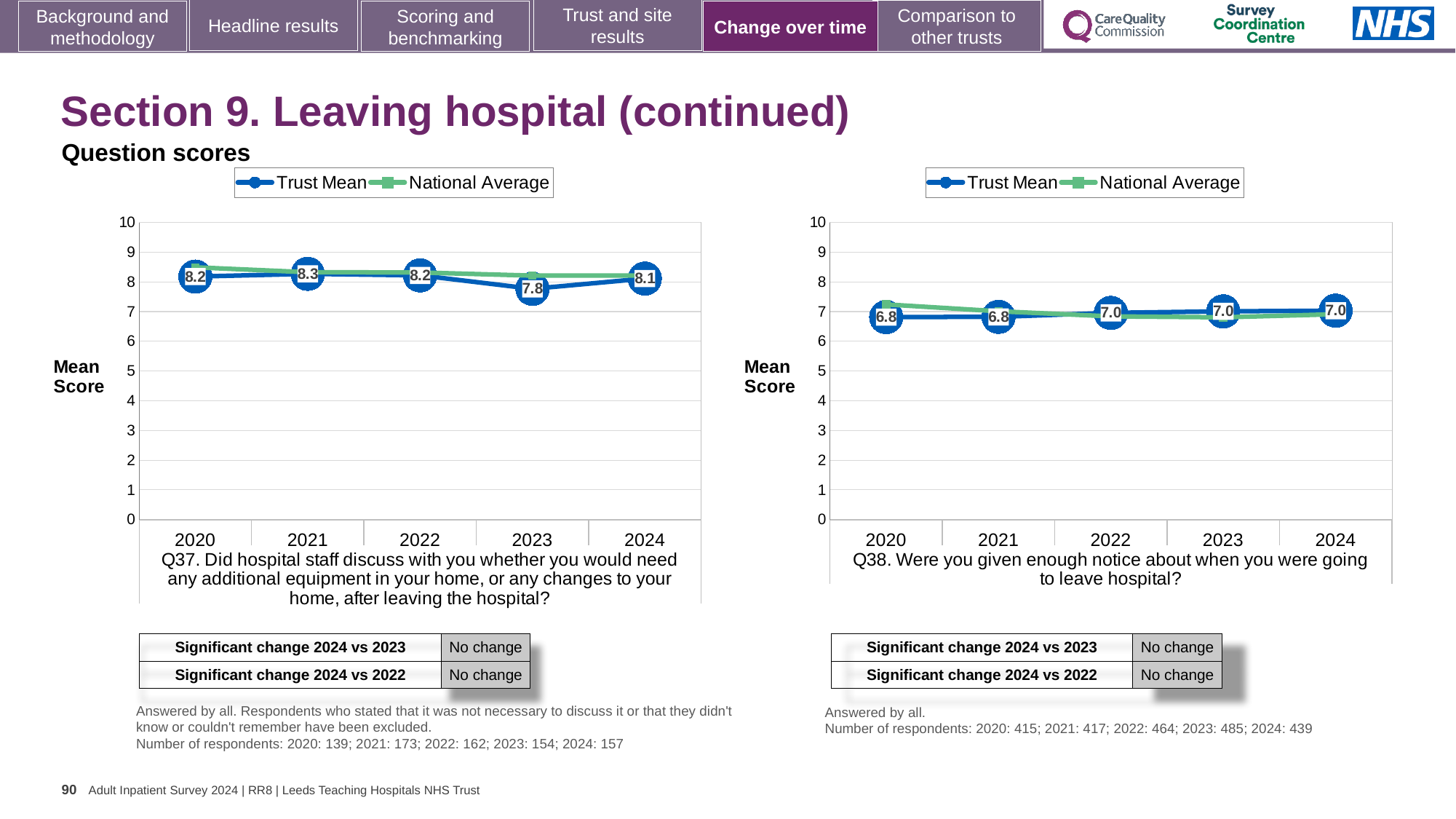
On the Q37 chart (left), what is the difference between the Trust Mean scores for 2021 and 2023? 0.5 On the Q37 chart (left), which year has the lowest Trust Mean score? 2023 What type of chart is used for Q38 (right)? Line chart How many series does the legend of the Q37 chart (left) list? 2 On the Q37 chart (left), is the National Average for 2020 greater or less than 8? greater How many years are shown on the x axis of the Q38 chart (right)? 5 On the Q38 chart (right), what is the Trust Mean score for 2020? 6.8 On the Q37 chart (left), which year has the highest Trust Mean score? 2021 On the Q37 chart (left), is the Trust Mean score higher in 2022 or in 2023? 2022 On the Q38 chart (right), what is the difference between the Trust Mean scores for 2024 and 2020? 0.2 On the Q38 chart (right), is the National Average for 2020 greater or less than 8? less On the Q37 chart (left), what is the Trust Mean score for 2023? 7.8